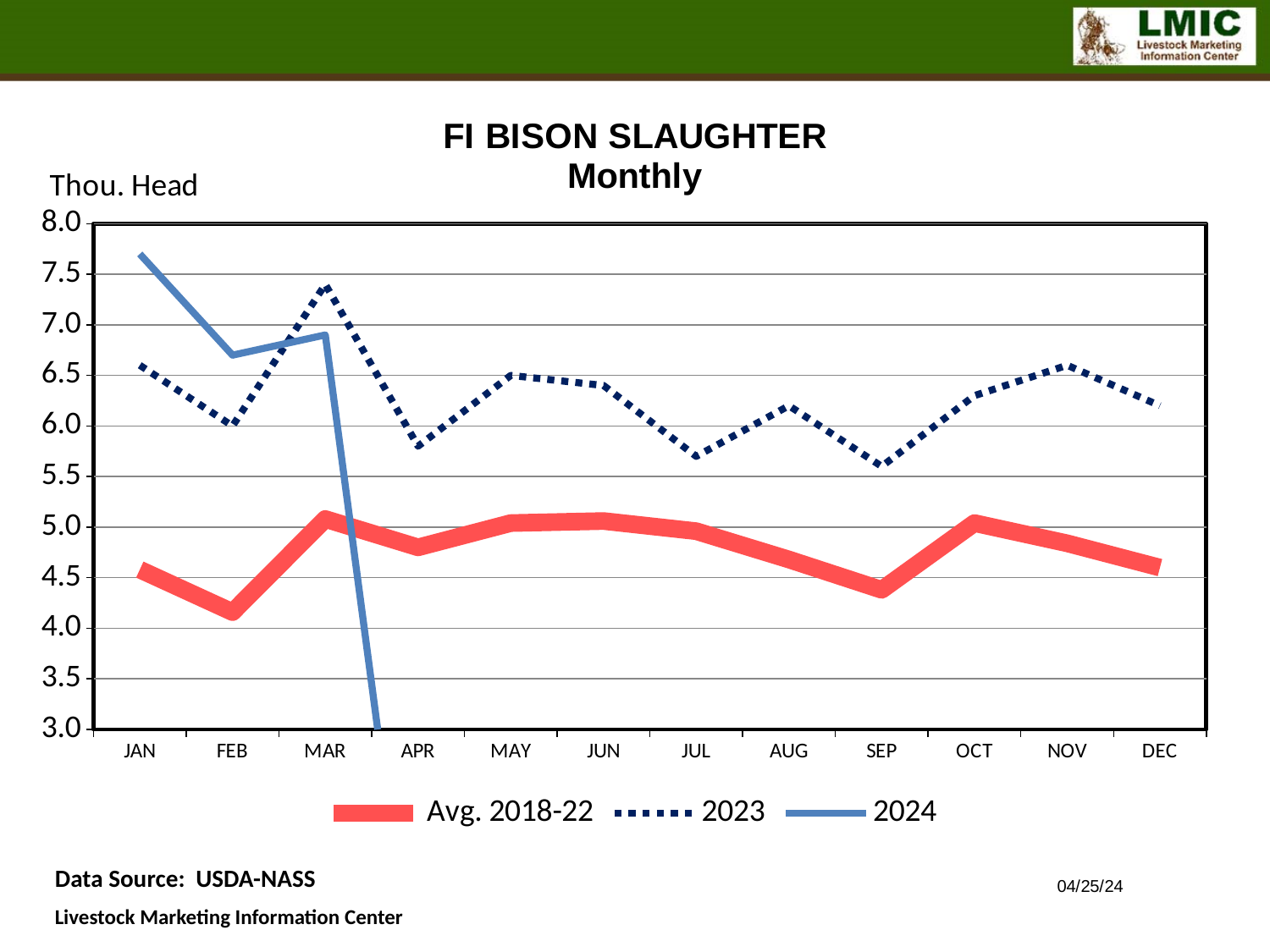
How many series does the legend list? 3 In which month does the 2023 series reach its highest value? MAR Does the 2024 series rise or fall from JAN to FEB? Fall In which month does the Avg. 2018-22 series reach its lowest value? FEB How many months are shown along the x axis? 12 Is the 2023 value for APR greater or less than 6.0? less What unit is shown on the y axis label? Thou. Head What kind of chart is shown on the slide? Line chart Is the 2024 value for JAN greater or less than 7.5? greater In which month does the 2024 series reach its highest value? JAN Which is larger in MAR, the 2023 value or the 2024 value? 2023 What is the title of the chart? FI BISON SLAUGHTER Monthly